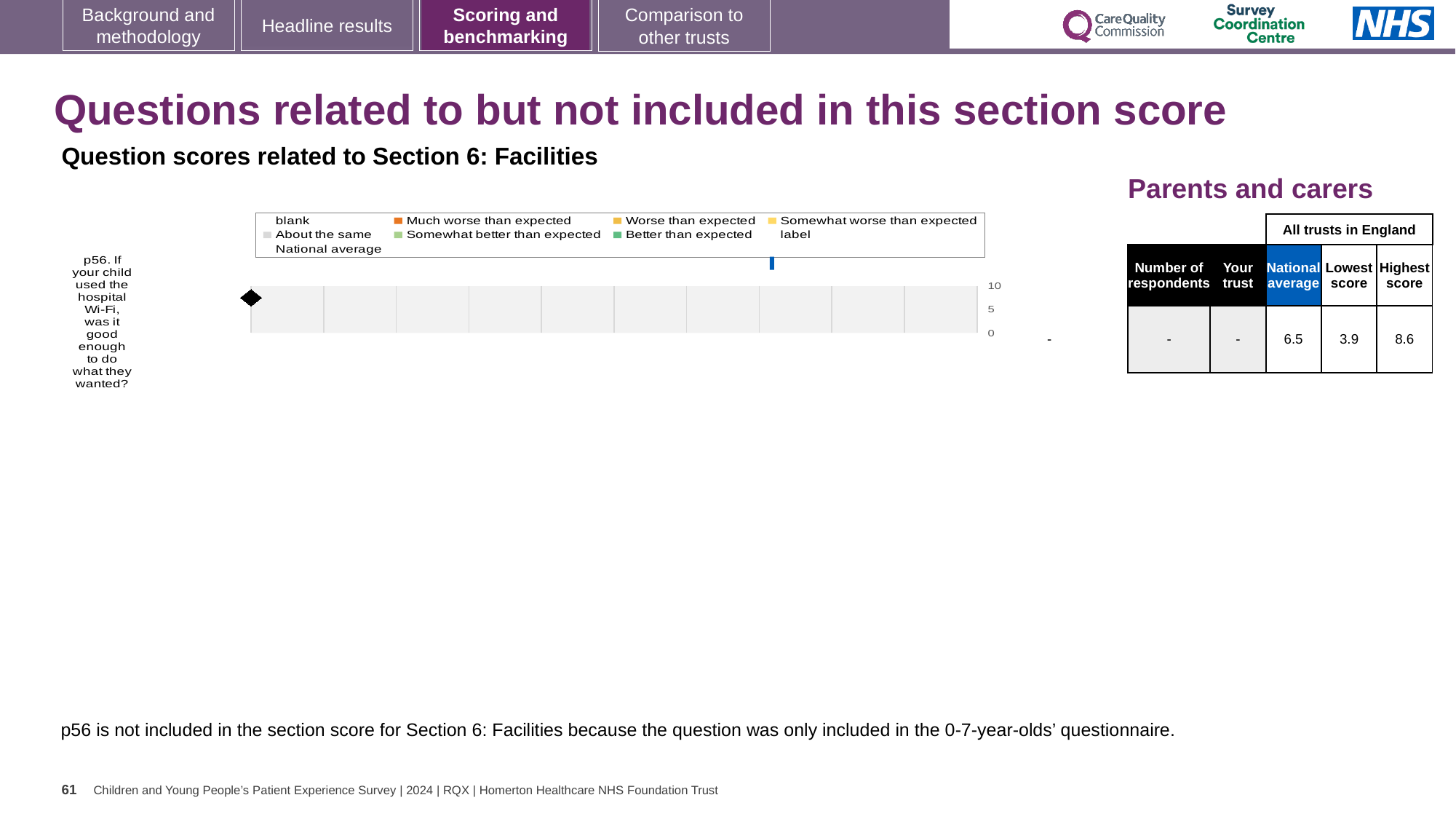
In the Parents and carers table, what is shown as the Your trust score for p56? - What is the highest tick value shown on the chart's vertical axis? 10 In the Parents and carers table, what is the Highest score for p56 across all trusts in England? 8.6 Which question is plotted on the chart? p56. If your child used the hospital Wi-Fi, was it good enough to do what they wanted? Is the National average score for p56 greater or less than 5? greater In the Parents and carers table, what is the National average score for p56? 6.5 How many questions are plotted on the chart? 1 In the Parents and carers table, what is the Lowest score for p56 across all trusts in England? 3.9 What is the difference between the Highest score and the Lowest score for p56 in the Parents and carers table? 4.7 What kind of chart is shown for question p56? Bar chart Which is larger for p56: the National average or the Lowest score? National average